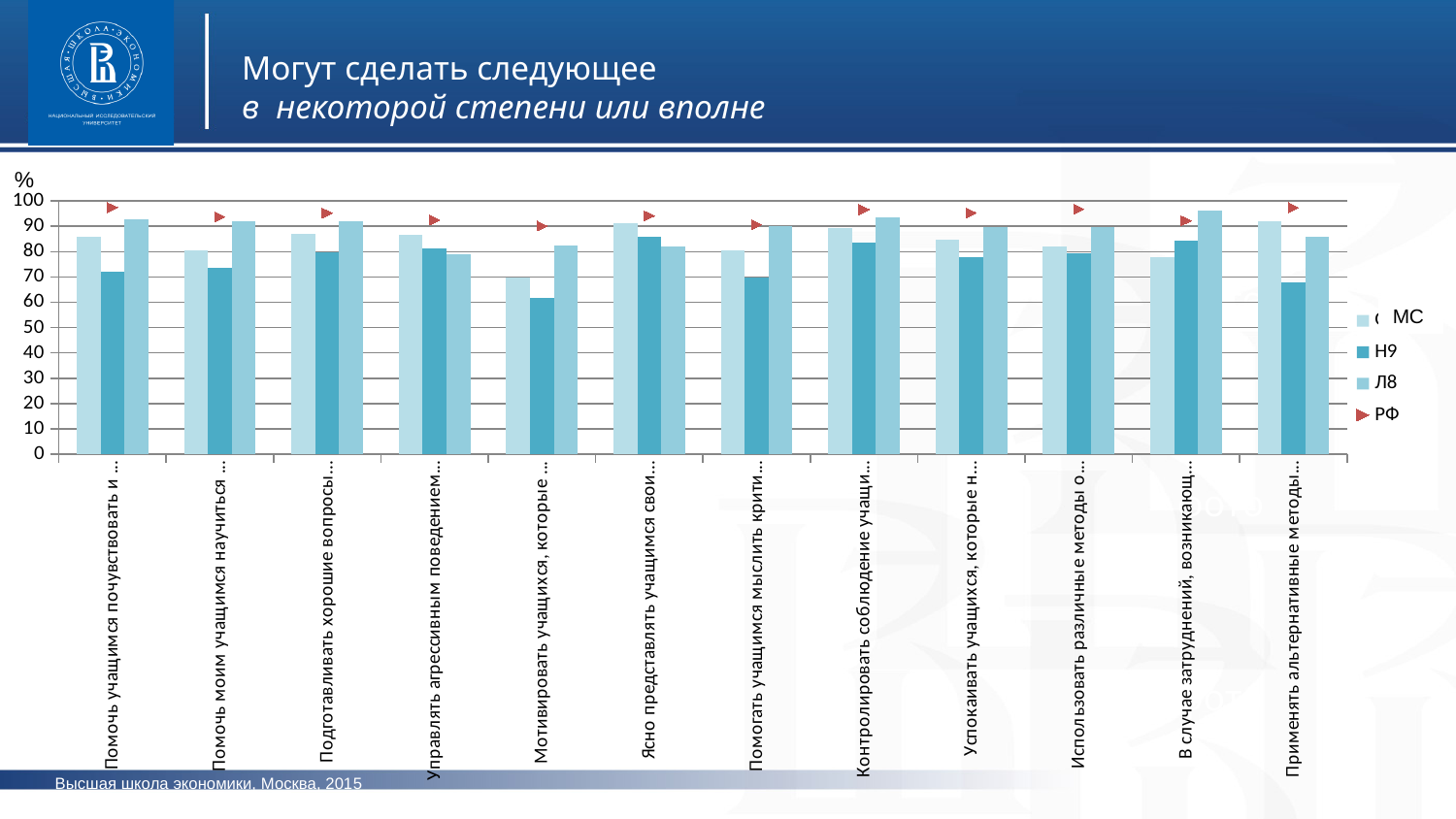
How many categories are shown along the x axis? 12 What kind of chart is shown on the slide? bar chart Is the Л8 value for "Помочь учащимся почувствовать и ..." greater or less than 90? greater For "Мотивировать учащихся, которые ...", which is larger: the Н9 value or the Л8 value? Л8 Which series is shown with triangular markers rather than bars? РФ Is the Л8 value for "В случае затруднений, возникающ..." greater or less than 90? greater How many series does the legend list? 4 What is the title of the chart on the slide? Могут сделать следующее в некоторой степени или вполне Is the Н9 value for "Применять альтернативные методы..." greater or less than 60? greater For which category is the Н9 value the lowest? Мотивировать учащихся, которые ...